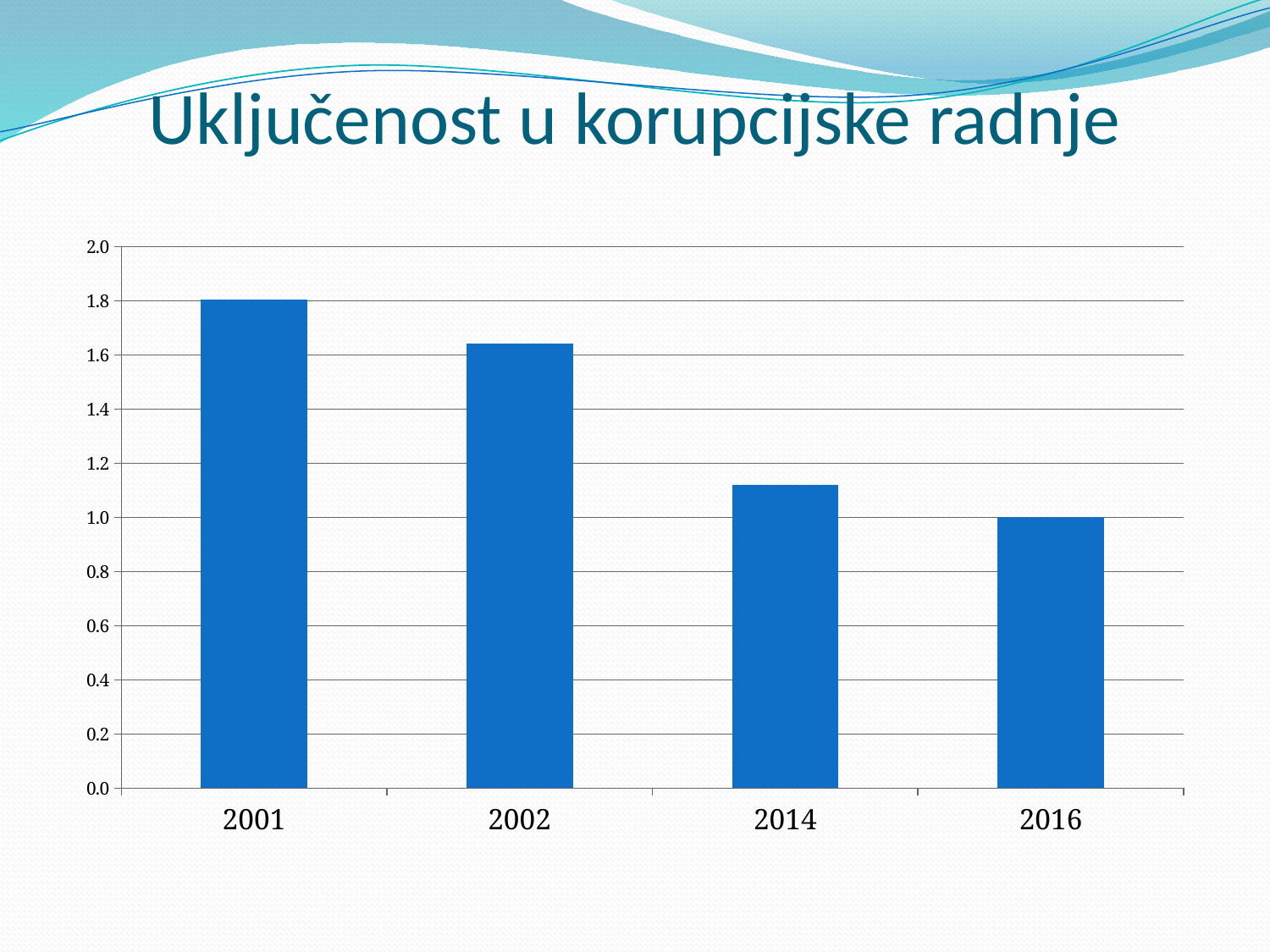
Is the value for 2002 greater or less than 1.6? greater Which is larger, the value for 2002 or the value for 2014? 2002 How many categories (years) are shown on the x axis? 4 What kind of chart is shown on the slide? bar chart What is the value for 2016? 1.0 Is the value for 2014 greater or less than 1.2? less Which year has the highest value? 2001 Do the values rise or fall from 2001 to 2016? fall Which year has the lowest value? 2016 What is the title of the chart? Uključenost u korupcijske radnje